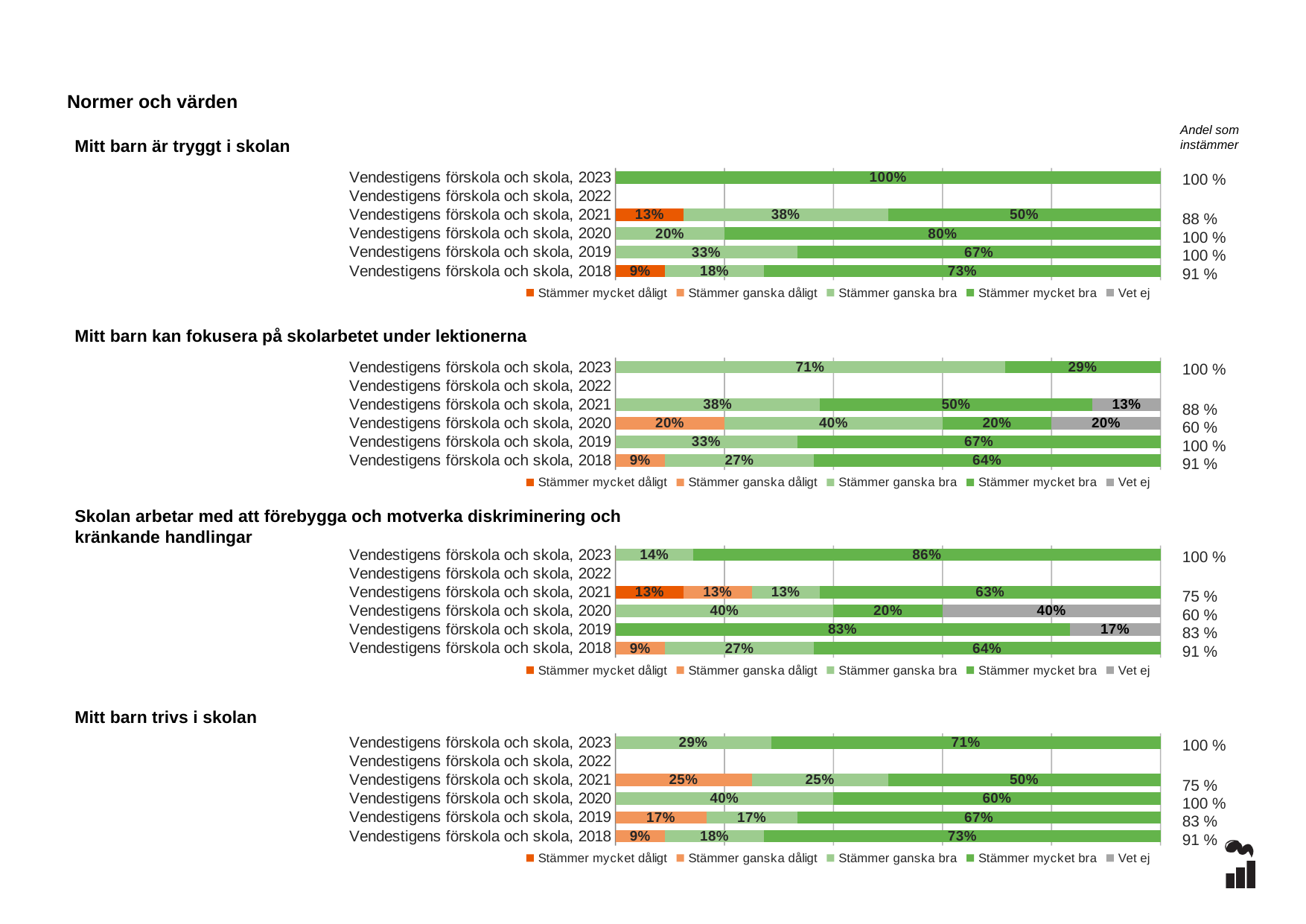
In the chart 'Mitt barn kan fokusera på skolarbetet under lektionerna', what is the 'Vet ej' value for Vendestigens förskola och skola, 2020? 20% In the chart 'Skolan arbetar med att förebygga och motverka diskriminering och kränkande handlingar', what is the 'Stämmer mycket bra' value for Vendestigens förskola och skola, 2019? 83% In the chart 'Skolan arbetar med att förebygga och motverka diskriminering och kränkande handlingar', which year has the lowest 'Andel som instämmer'? Vendestigens förskola och skola, 2020 In the chart 'Mitt barn trivs i skolan', which is larger: the 'Stämmer mycket bra' value for 2020 or for 2019? 2019 In the chart 'Mitt barn trivs i skolan', what is the difference between the 'Stämmer mycket bra' values for 2023 and 2021? 21% How many series does the legend list in the chart 'Mitt barn är tryggt i skolan'? 5 In the chart 'Mitt barn trivs i skolan', what is the 'Stämmer ganska dåligt' value for Vendestigens förskola och skola, 2021? 25% In the chart 'Mitt barn är tryggt i skolan', what is the 'Stämmer mycket dåligt' value for Vendestigens förskola och skola, 2021? 13% In the chart 'Mitt barn kan fokusera på skolarbetet under lektionerna', what is the 'Andel som instämmer' for Vendestigens förskola och skola, 2020? 60 % How many category rows are shown in the chart 'Mitt barn kan fokusera på skolarbetet under lektionerna'? 6 What kind of chart is 'Mitt barn trivs i skolan'? Stacked bar chart In the chart 'Mitt barn är tryggt i skolan', what is the 'Stämmer mycket bra' value for Vendestigens förskola och skola, 2023? 100%